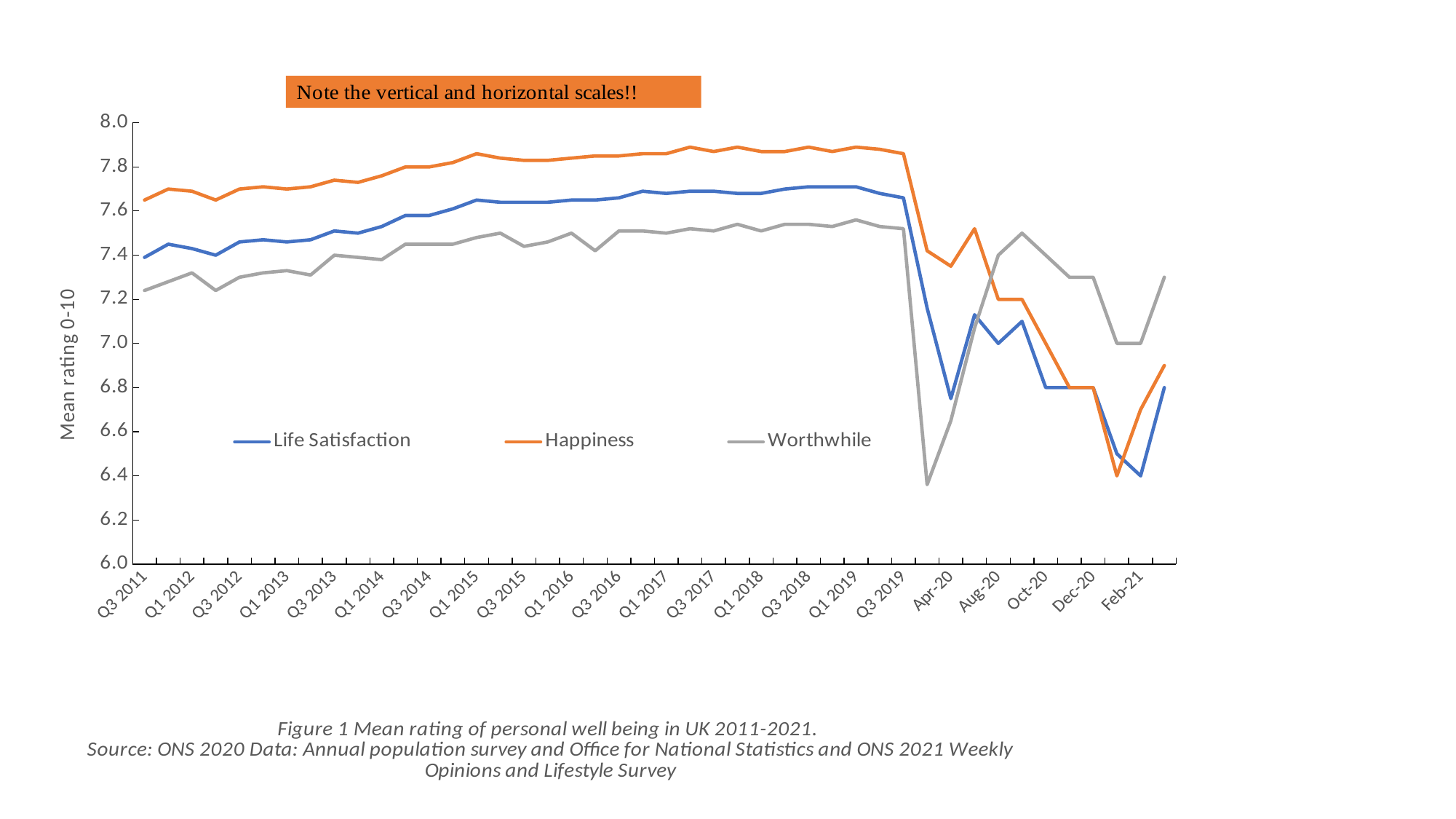
How many series does the legend list? 3 Which series has the highest value at Q3 2011? Happiness At Apr-20, which is higher: Happiness or Worthwhile? Happiness What is the label on the vertical axis? Mean rating 0-10 What kind of chart is shown on the slide? line chart What are the three series named in the legend? Life Satisfaction, Happiness, Worthwhile Which series has the lowest value at Q3 2011? Worthwhile Does the Life Satisfaction series generally rise or fall from Q3 2011 to Q1 2019? rise Is the Worthwhile value at Q3 2011 greater or less than 7.4? less Is the Happiness value at Q3 2011 greater or less than 7.4? greater Is the Life Satisfaction value at Q1 2019 greater or less than 7.6? greater